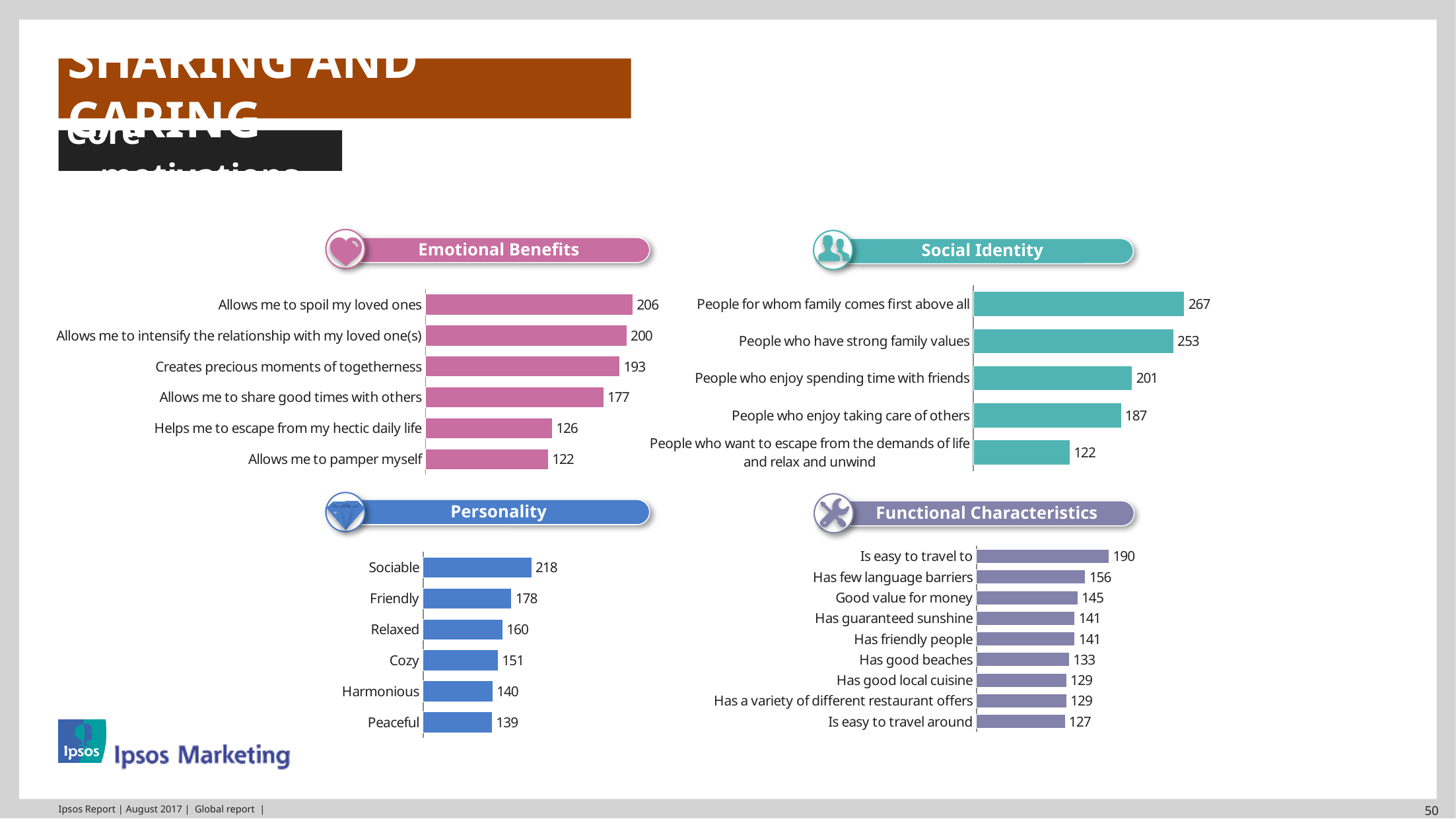
In the Personality chart, which category has the lowest value? Peaceful In the Social Identity chart, what is the difference between "People who have strong family values" and "People who enjoy taking care of others"? 66 In the Functional Characteristics chart, what is the value for "Has few language barriers"? 156 In the Social Identity chart, which category has the highest value? People for whom family comes first above all In the Emotional Benefits chart, what is the difference between "Allows me to share good times with others" and "Allows me to pamper myself"? 55 What kind of chart is the Personality chart? Bar chart In the Personality chart, which is larger: Sociable or Relaxed? Sociable How many categories are shown in the Functional Characteristics chart? 9 How many categories are shown in the Emotional Benefits chart? 6 In the Emotional Benefits chart, what is the value for "Allows me to spoil my loved ones"? 206 What colour are the bars in the Social Identity chart? Teal In the Functional Characteristics chart, which category has the highest value? Is easy to travel to